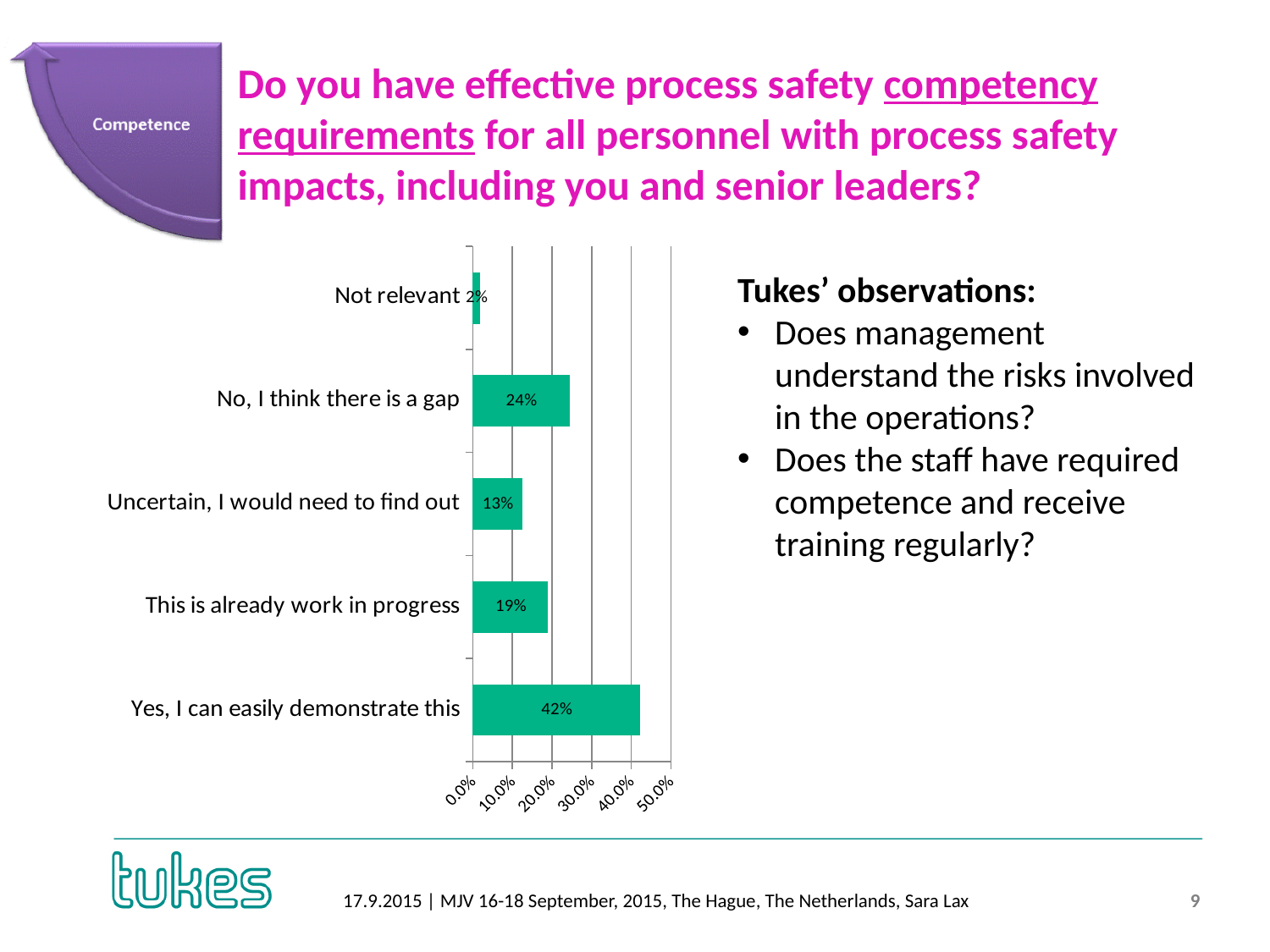
What is the value for "This is already work in progress"? 19% Which response category has the highest value? Yes, I can easily demonstrate this What is the value for "No, I think there is a gap"? 24% Is the value for "Yes, I can easily demonstrate this" greater or less than 40.0%? greater What is the maximum value shown on the chart's percentage axis? 50.0% Which is larger: "This is already work in progress" or "Uncertain, I would need to find out"? This is already work in progress What is the value for "Uncertain, I would need to find out"? 13% What is the difference between "Yes, I can easily demonstrate this" and "No, I think there is a gap"? 18% How many response categories are shown in the chart? 5 What percentage of respondents answered "Yes, I can easily demonstrate this"? 42% Which response category has the lowest value? Not relevant What kind of chart is shown on the slide? Bar chart